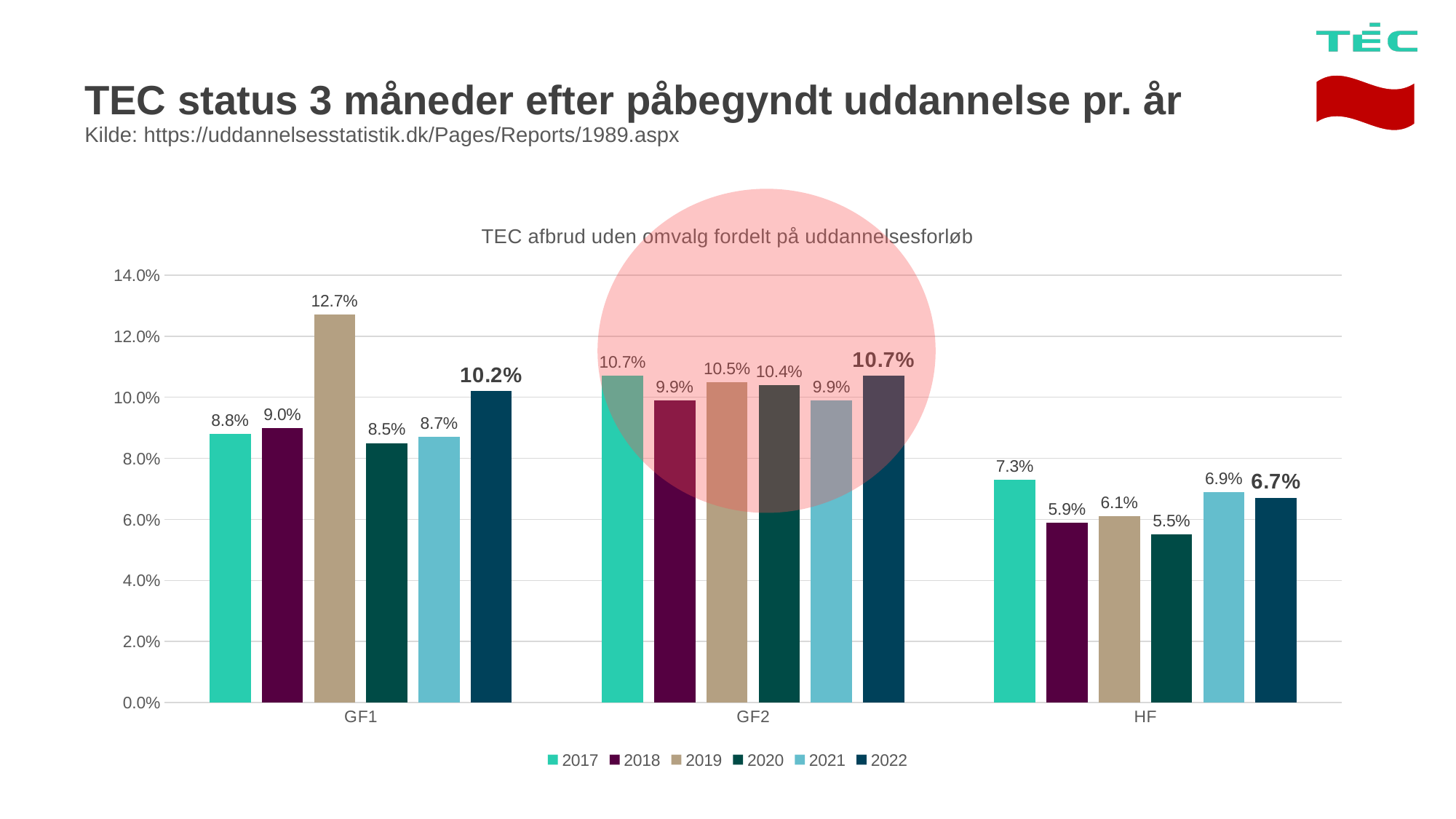
What is the value for 2019 in the GF1 category? 12.7% How many categories are shown on the x axis? 3 Which is larger: the 2017 value for GF2 or the 2017 value for HF? 2017 value for GF2 What is the value for 2020 in the GF2 category? 10.4% What is the value for 2022 in the HF category? 6.7% What is the title of the chart? TEC afbrud uden omvalg fordelt på uddannelsesforløb Which year has the highest value in the GF1 category? 2019 Which year has the lowest value in the HF category? 2020 What kind of chart is shown on the slide? Bar chart What is the difference between the 2019 and 2020 values in the GF1 category? 4.2% Is the value for 2018 in the HF category greater or less than 6.0%? less How many series does the legend list? 6